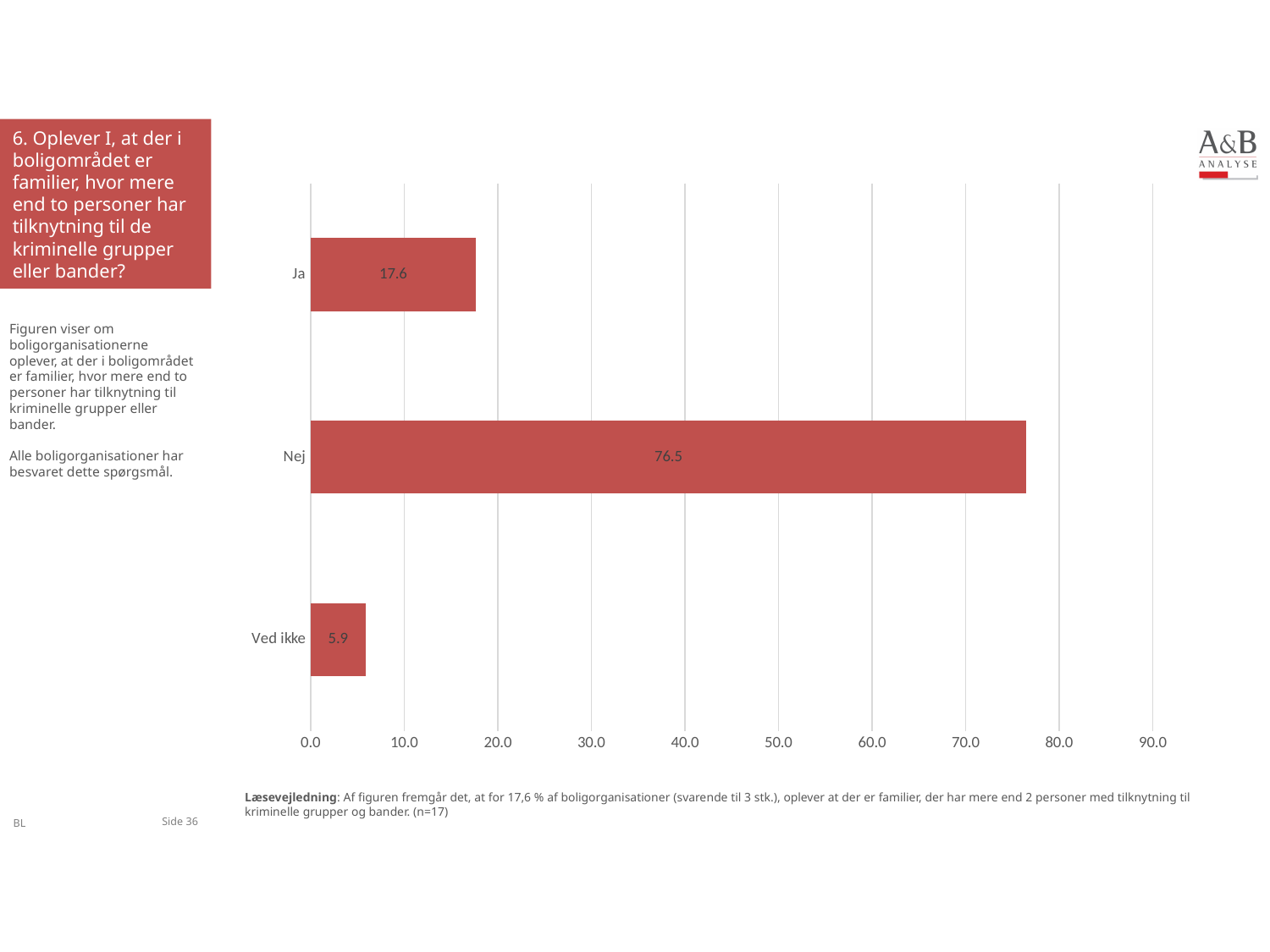
Is the value for "Nej" greater or less than 70.0? greater Which is larger, the value for "Ja" or the value for "Ved ikke"? Ja What is the value for "Ja"? 17.6 What is the value for "Ved ikke"? 5.9 What kind of chart is shown on the slide? Bar chart What is the value for "Nej"? 76.5 What is the difference between the values for "Ja" and "Ved ikke"? 11.7 Which category has the lowest value? Ved ikke What is the highest tick value shown on the horizontal axis? 90.0 What is the difference between the values for "Nej" and "Ja"? 58.9 How many categories are shown in the chart? 3 Which category has the highest value? Nej